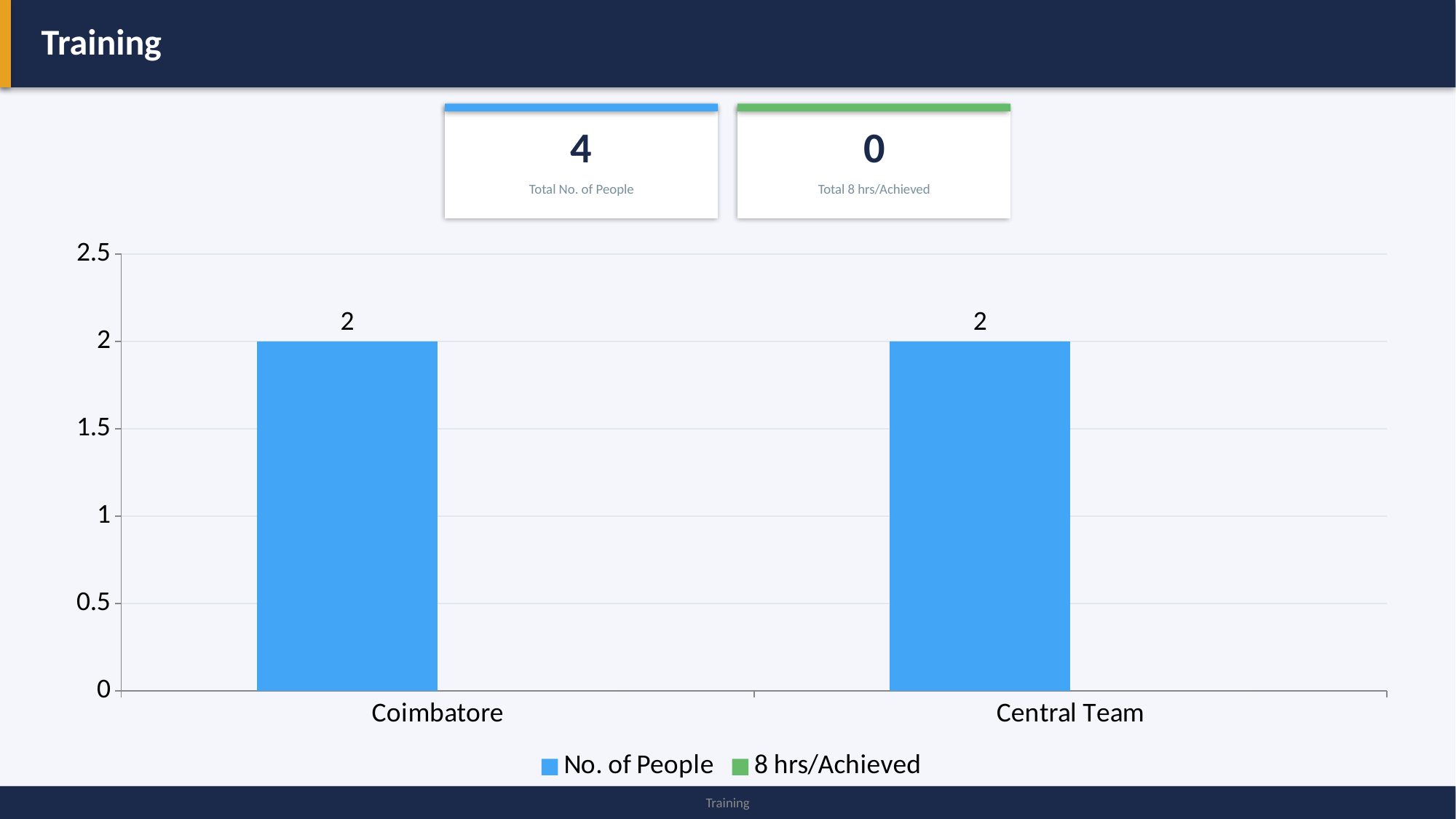
Is the No. of People value for Coimbatore larger than, smaller than, or equal to the value for Central Team? equal What colour represents the 'No. of People' series in the legend? blue How many series does the chart legend list? 2 Is the No. of People value for Coimbatore greater or less than 1? greater What is the No. of People value for Central Team? 2 What value is shown on the 'Total No. of People' card above the chart? 4 What is the difference between the No. of People values for Coimbatore and Central Team? 0 What is the No. of People value for Coimbatore? 2 What value is shown on the 'Total 8 hrs/Achieved' card above the chart? 0 How many categories are shown on the x axis of the chart? 2 What kind of chart is shown on the slide? bar chart Is the No. of People value for Central Team greater or less than 2.5? less